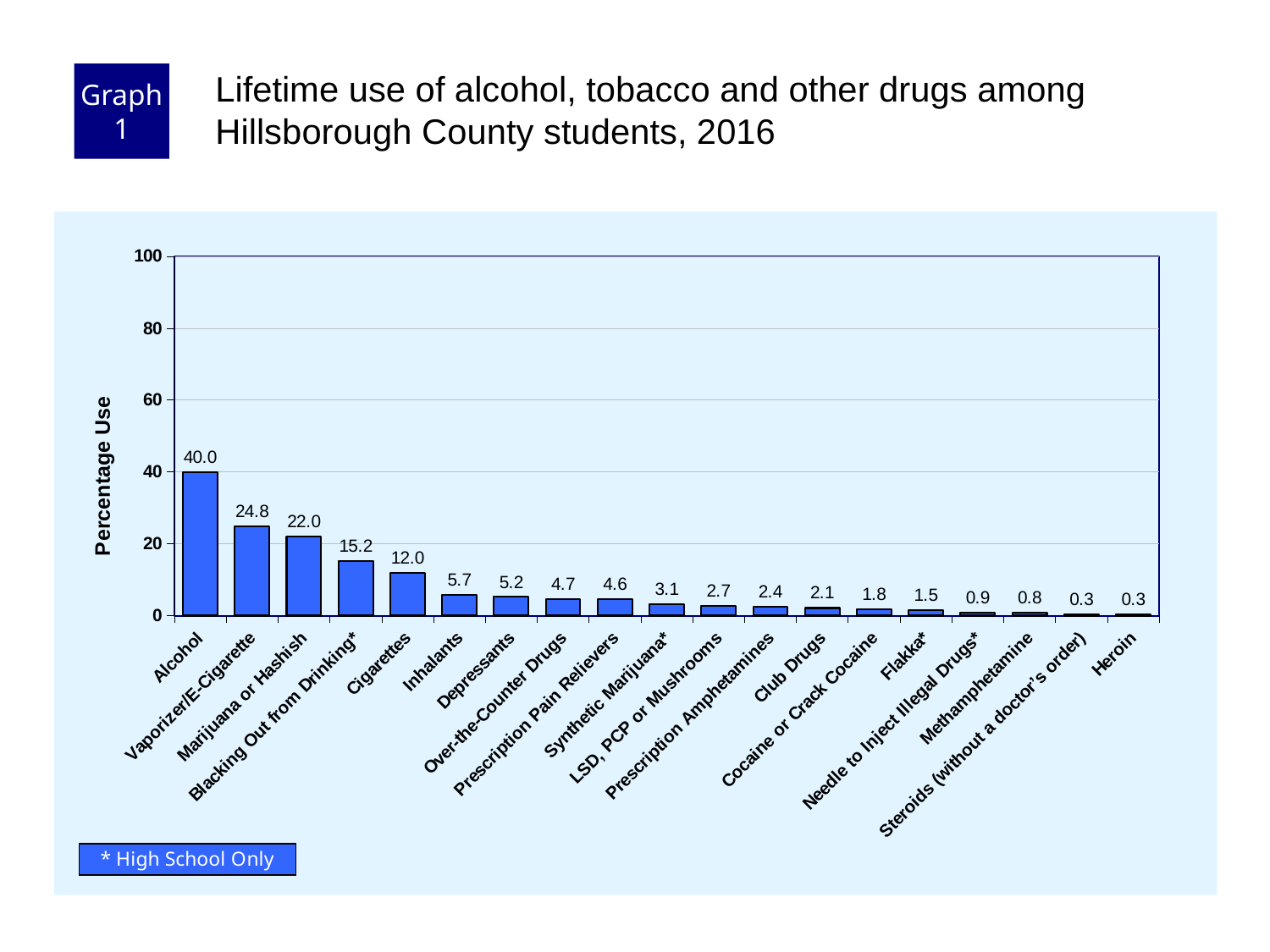
What is the percentage use for Vaporizer/E-Cigarette? 24.8 What is the label of the y axis? Percentage Use What is the difference in percentage use between Inhalants and Depressants? 0.5 Is the value for Vaporizer/E-Cigarette greater or less than 20? greater What is the percentage use for Club Drugs? 2.1 Which category has the highest percentage use? Alcohol What kind of chart is shown on the slide? Bar chart Which has a higher percentage use, Blacking Out from Drinking* or Cigarettes? Blacking Out from Drinking* What is the difference in percentage use between Alcohol and Marijuana or Hashish? 18.0 How many categories are shown on the x axis? 19 What is the percentage use for Alcohol? 40.0 What is the percentage use for Cigarettes? 12.0